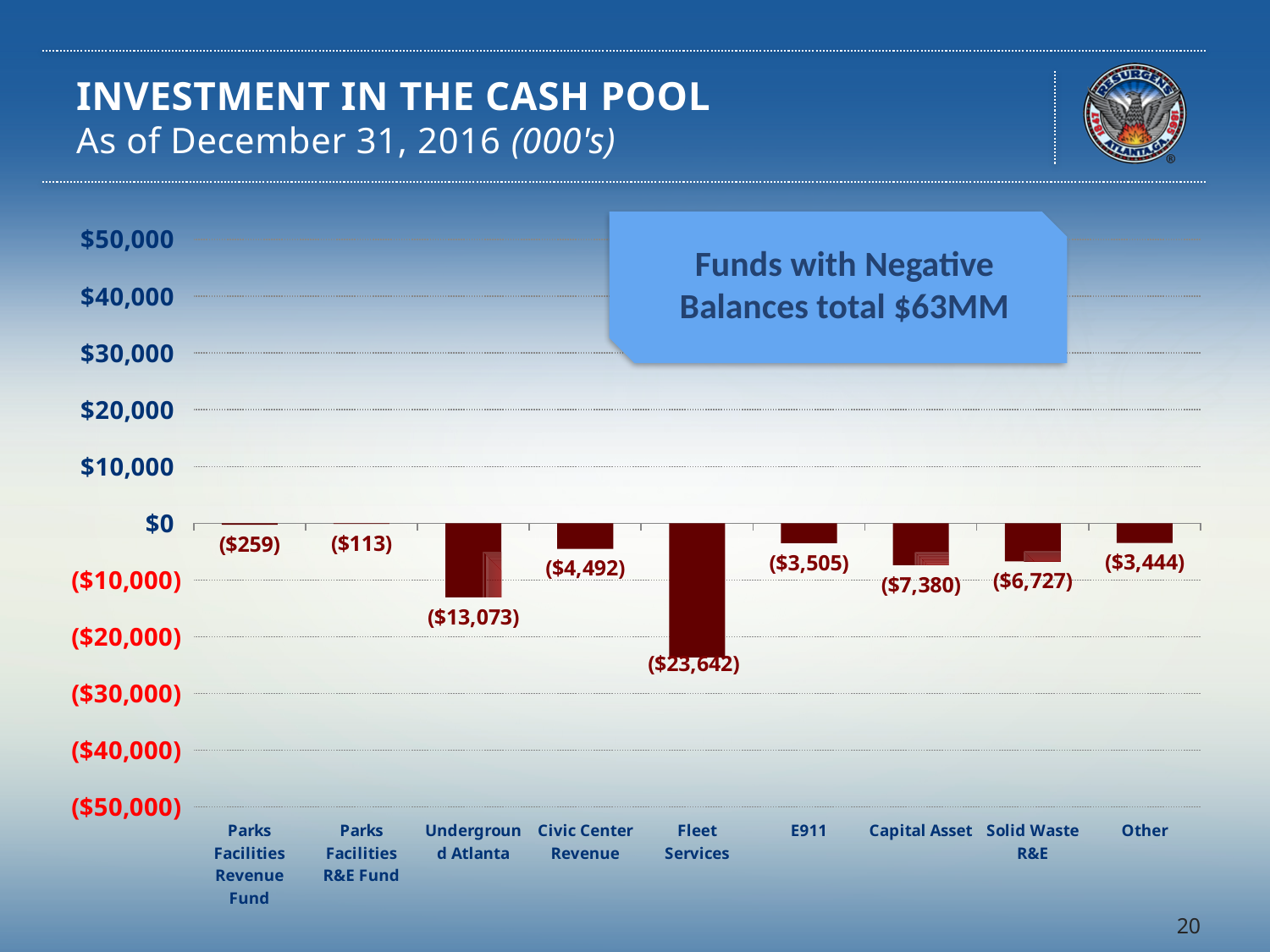
By how much does the negative balance of Fleet Services exceed that of Underground Atlanta? $10,569 Which category has the smallest negative balance (closest to $0)? Parks Facilities R&E Fund Which has the larger negative balance, Capital Asset or Solid Waste R&E? Capital Asset What is the value shown for E911? ($3,505) How many categories are shown on the x axis? 9 What kind of chart is shown on the slide? Bar chart According to the callout box, what do the funds with negative balances total? $63MM What is the value shown for the Parks Facilities R&E Fund? ($113) Which category has the largest negative balance? Fleet Services What is the value shown for Fleet Services? ($23,642) What is the value shown for Underground Atlanta? ($13,073) What is the title of the slide's chart? INVESTMENT IN THE CASH POOL